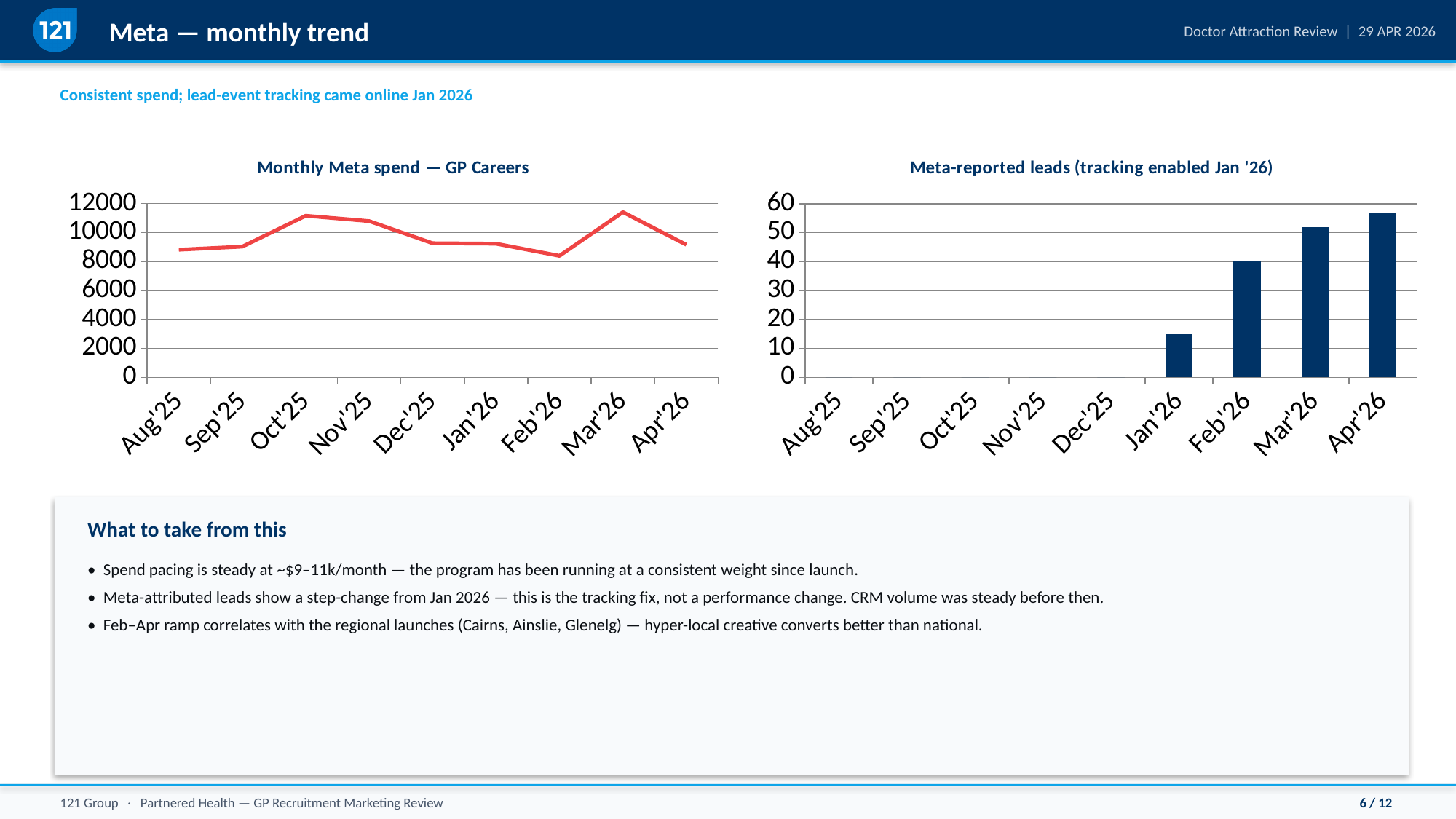
In the 'Meta-reported leads (tracking enabled Jan '26)' chart, is the value for Apr'26 greater or less than 50? greater In the 'Monthly Meta spend — GP Careers' chart, how many months are shown on the x axis? 9 In the 'Monthly Meta spend — GP Careers' chart, is the value for Oct'25 greater or less than 10000? greater What is the title of the chart on the right of the slide? Meta-reported leads (tracking enabled Jan '26) In the 'Meta-reported leads (tracking enabled Jan '26)' chart, do the values rise or fall from Jan'26 to Apr'26? rise What kind of chart is the 'Meta-reported leads (tracking enabled Jan '26)' chart? bar chart In the 'Meta-reported leads (tracking enabled Jan '26)' chart, which is larger, the value for Feb'26 or Mar'26? Mar'26 In the 'Meta-reported leads (tracking enabled Jan '26)' chart, which month has the highest number of leads? Apr'26 What kind of chart is the 'Monthly Meta spend — GP Careers' chart? line chart In the 'Monthly Meta spend — GP Careers' chart, which month has the highest spend? Mar'26 In the 'Meta-reported leads (tracking enabled Jan '26)' chart, is the value for Jan'26 greater or less than 20? less